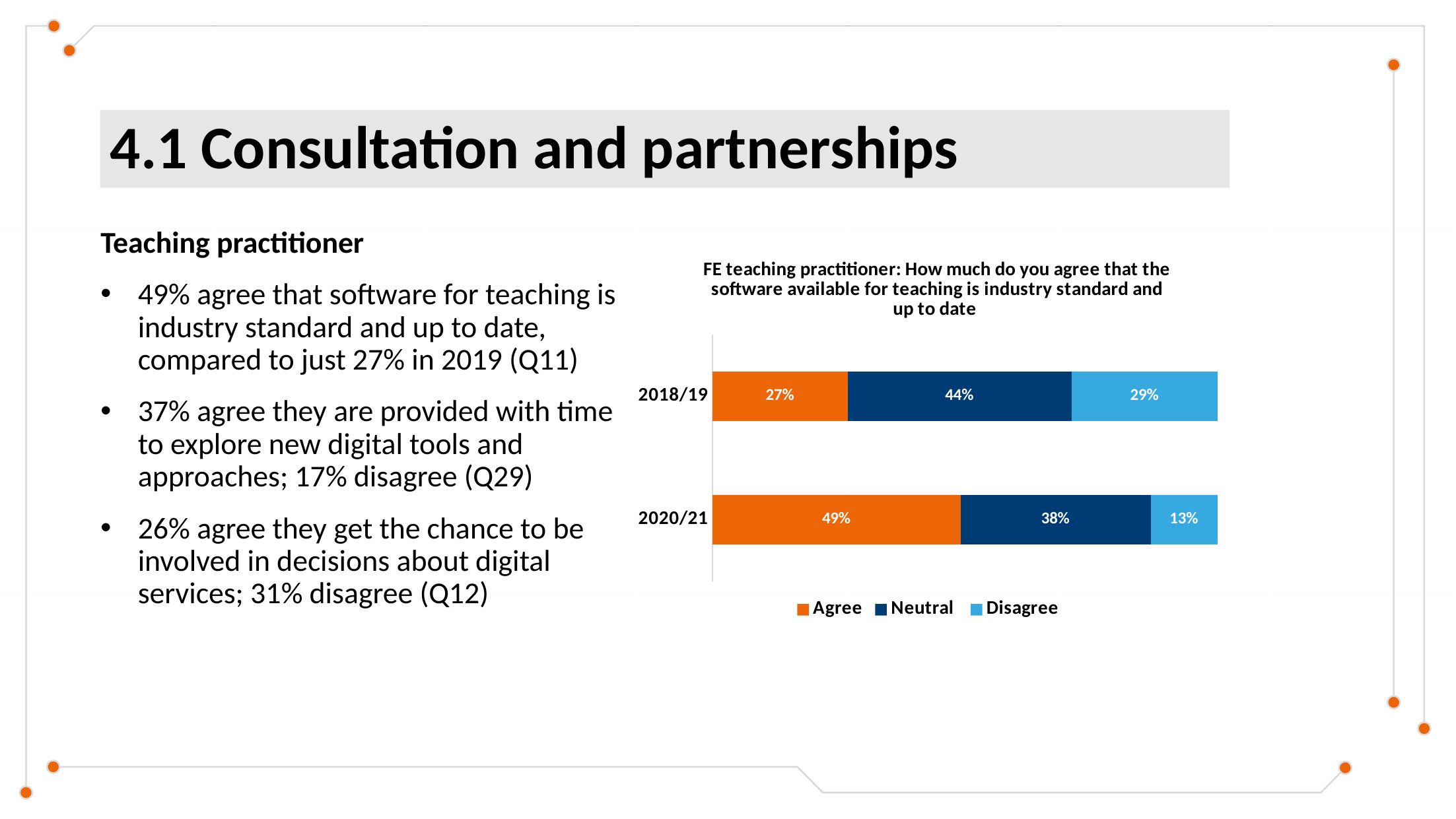
What is the Disagree value for 2020/21? 13% How many years (categories) are shown on the chart? 2 By how many percentage points did the Agree share increase from 2018/19 to 2020/21? 22 Which year has the lower Disagree percentage? 2020/21 What is the Neutral value for 2018/19? 44% What is the Agree value for 2018/19? 27% Which year has the higher Agree percentage? 2020/21 What is the difference between the Disagree values for 2018/19 and 2020/21? 16 Which colour represents the Neutral series in the chart? Dark blue What percentage of FE teaching practitioners agreed in 2020/21? 49% What type of chart is shown? Stacked bar chart How many series does the legend list? 3